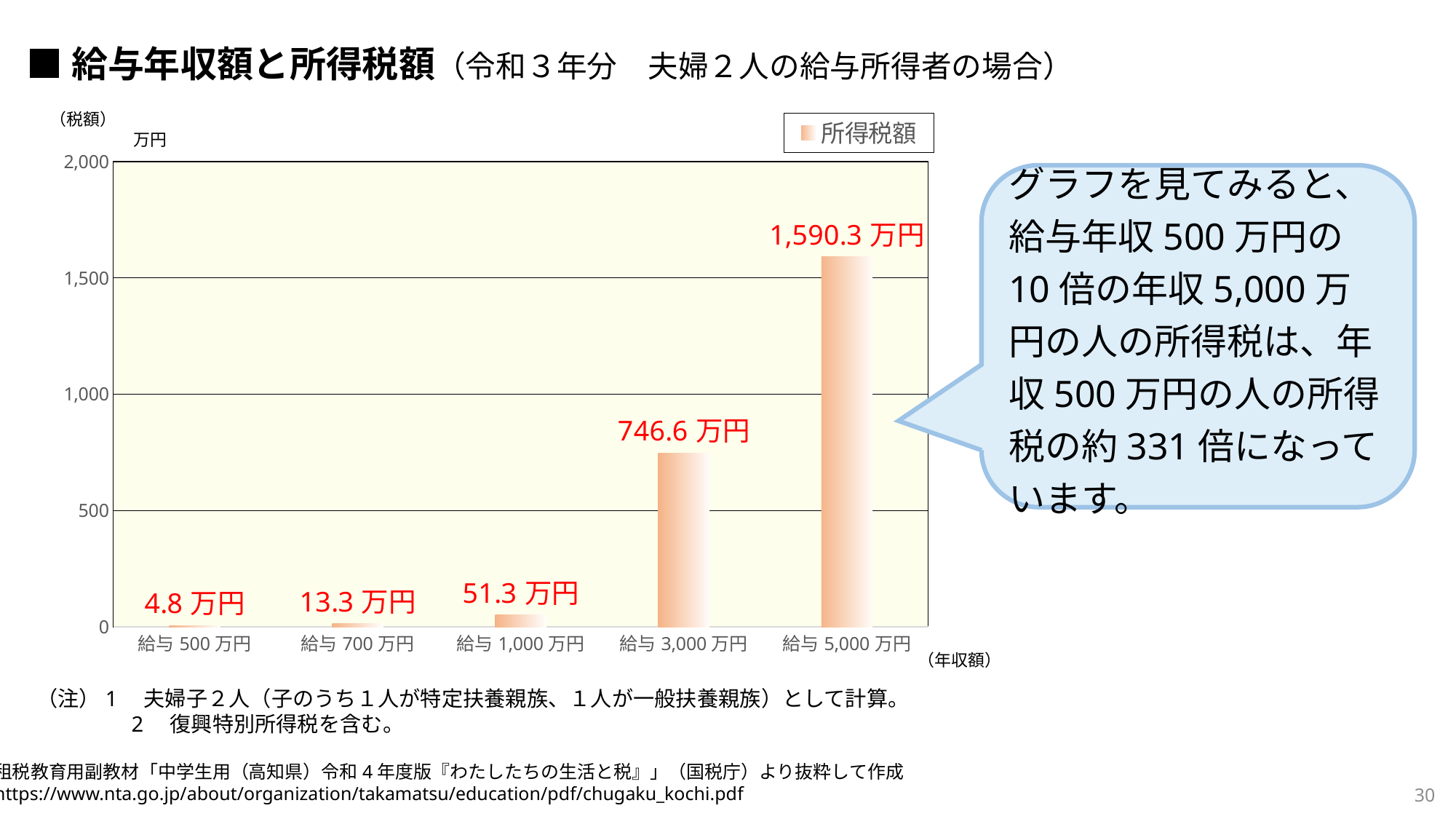
このグラフで、給与1,000万円の所得税額はいくらですか？ 51.3万円 このグラフで、給与500万円の所得税額はいくらですか？ 4.8万円 このグラフで、給与5,000万円の所得税額は1,500万円より大きいですか、小さいですか？ 大きい このグラフで、所得税額が最も高いのはどの給与年収額ですか？ 給与5,000万円 このグラフで、所得税額が最も低いのはどの給与年収額ですか？ 給与500万円 このグラフで、給与1,000万円と給与700万円では、どちらの所得税額が大きいですか？ 給与1,000万円 このグラフには給与年収額の区分がいくつありますか？ 5 このグラフの凡例には系列がいくつ示されていますか？ 1 このグラフで、給与3,000万円の所得税額はいくらですか？ 746.6万円 このグラフはどの種類のグラフですか？ 棒グラフ このグラフで、給与5,000万円と給与3,000万円の所得税額の差はいくらですか？ 843.7万円 このグラフで、給与700万円と給与500万円の所得税額の差はいくらですか？ 8.5万円